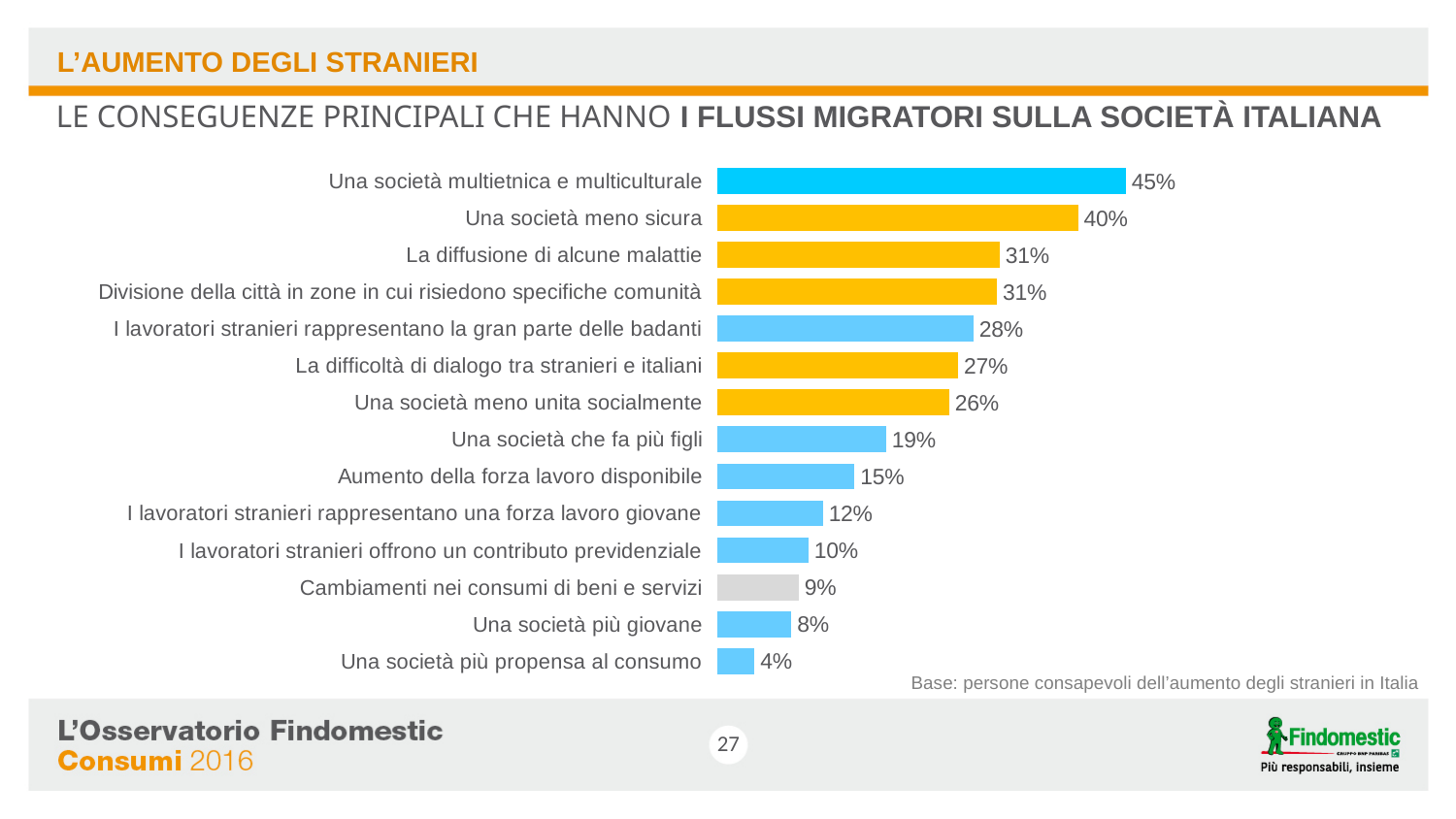
What is the value for "I lavoratori stranieri rappresentano la gran parte delle badanti"? 28% What is the value for "Una società meno sicura"? 40% What kind of chart is shown on the slide? Bar chart What is the value for "Una società multietnica e multiculturale"? 45% Which is larger: "La difficoltà di dialogo tra stranieri e italiani" or "Una società meno unita socialmente"? La difficoltà di dialogo tra stranieri e italiani Which category has the highest value? Una società multietnica e multiculturale What is the value for "Cambiamenti nei consumi di beni e servizi"? 9% How many categories are shown in the chart? 14 What is the difference between "Una società che fa più figli" and "Una società più giovane"? 11% Which category has the lowest value? Una società più propensa al consumo What is the difference between "Una società multietnica e multiculturale" and "Una società meno sicura"? 5% What colour is the bar for "Cambiamenti nei consumi di beni e servizi"? Grey